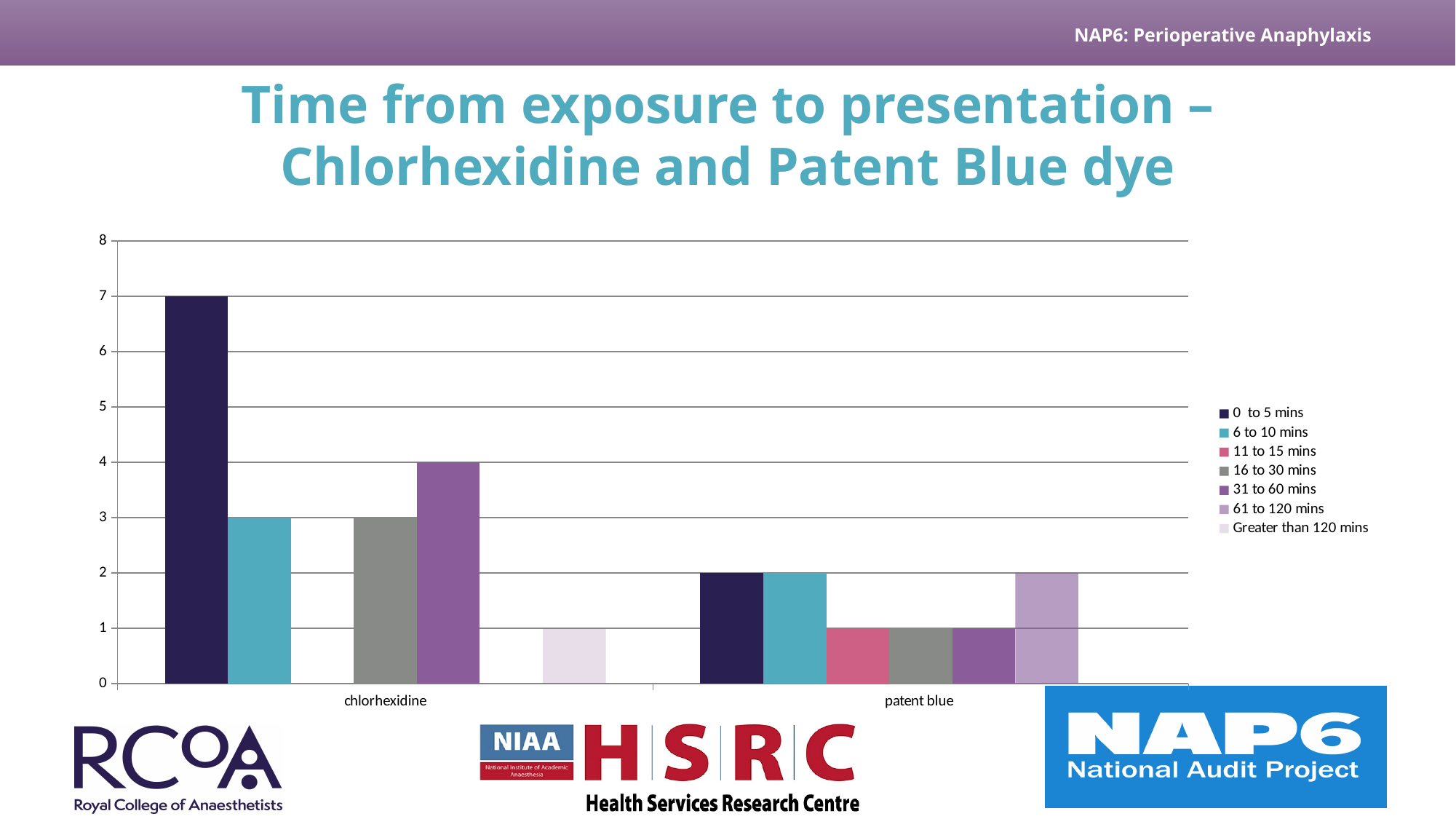
What is the difference between the 0 to 5 mins values for chlorhexidine and patent blue? 5 How many categories are shown on the x axis? 2 How many series does the legend list? 7 What is the value for 61 to 120 mins for patent blue? 2 What kind of chart is shown on the slide? bar chart Which time interval has the highest value for chlorhexidine? 0 to 5 mins What is the value for 0 to 5 mins for chlorhexidine? 7 Is the value for 0 to 5 mins for chlorhexidine greater or less than 5? greater What is the value for 31 to 60 mins for chlorhexidine? 4 Which is larger: the 6 to 10 mins value for chlorhexidine or for patent blue? chlorhexidine What is the title of the chart? Time from exposure to presentation – Chlorhexidine and Patent Blue dye What is the value for Greater than 120 mins for chlorhexidine? 1